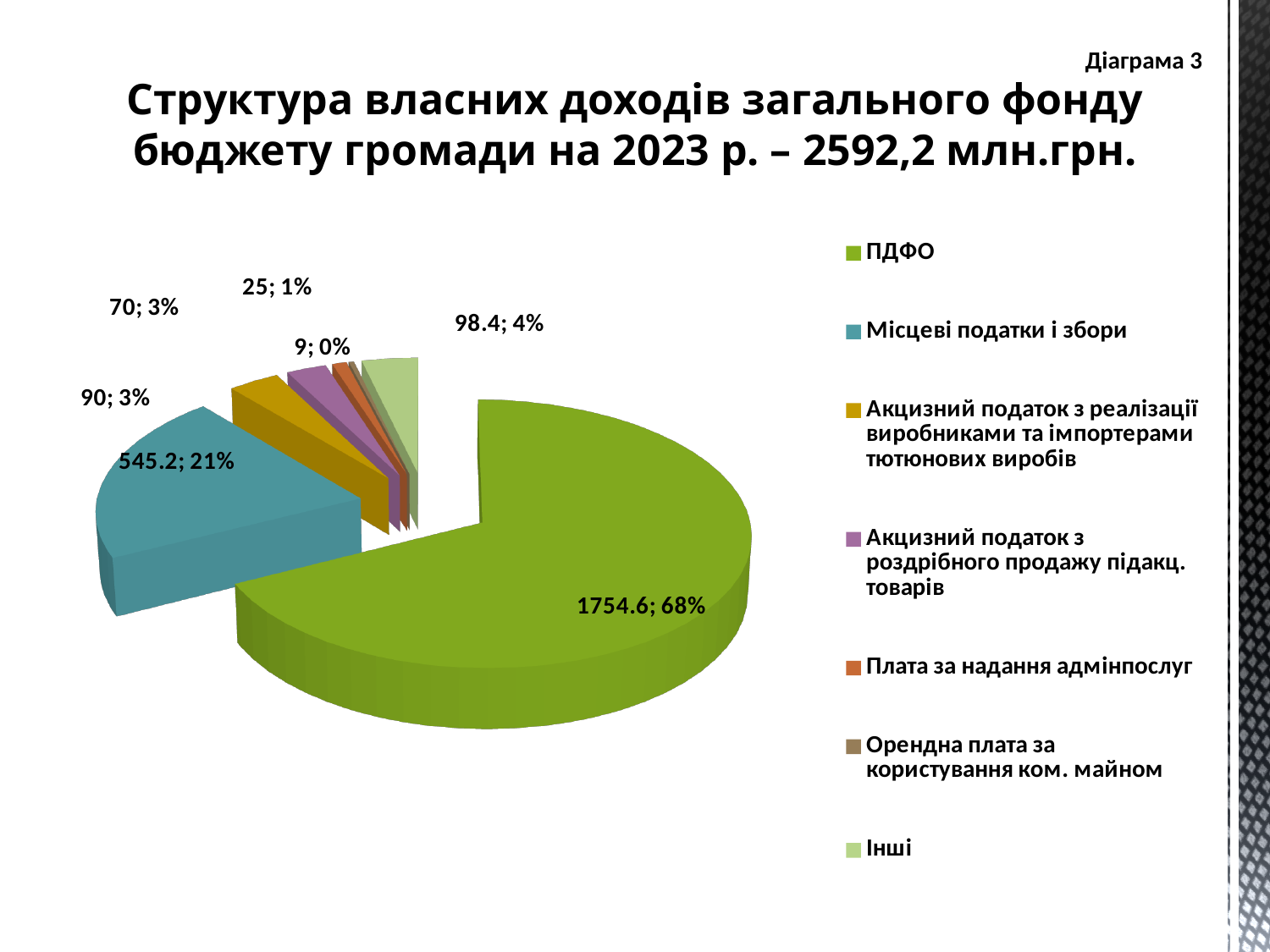
What share of the pie does ПДФО represent? 68% What share of the pie does Інші represent? 4% What value is shown for ПДФО? 1754.6 What share of the pie does Місцеві податки і збори represent? 21% What total amount is stated in the chart title for 2023? 2592,2 млн.грн. What value is shown for Місцеві податки і збори? 545.2 Which is larger, the value for Місцеві податки і збори or the value for Інші? Місцеві податки і збори Which category has the largest slice of the pie? ПДФО What value is shown for Інші? 98.4 What kind of chart is shown on the slide? pie chart How many categories does the legend list? 7 What is the difference between the values for ПДФО and Місцеві податки і збори? 1209.4